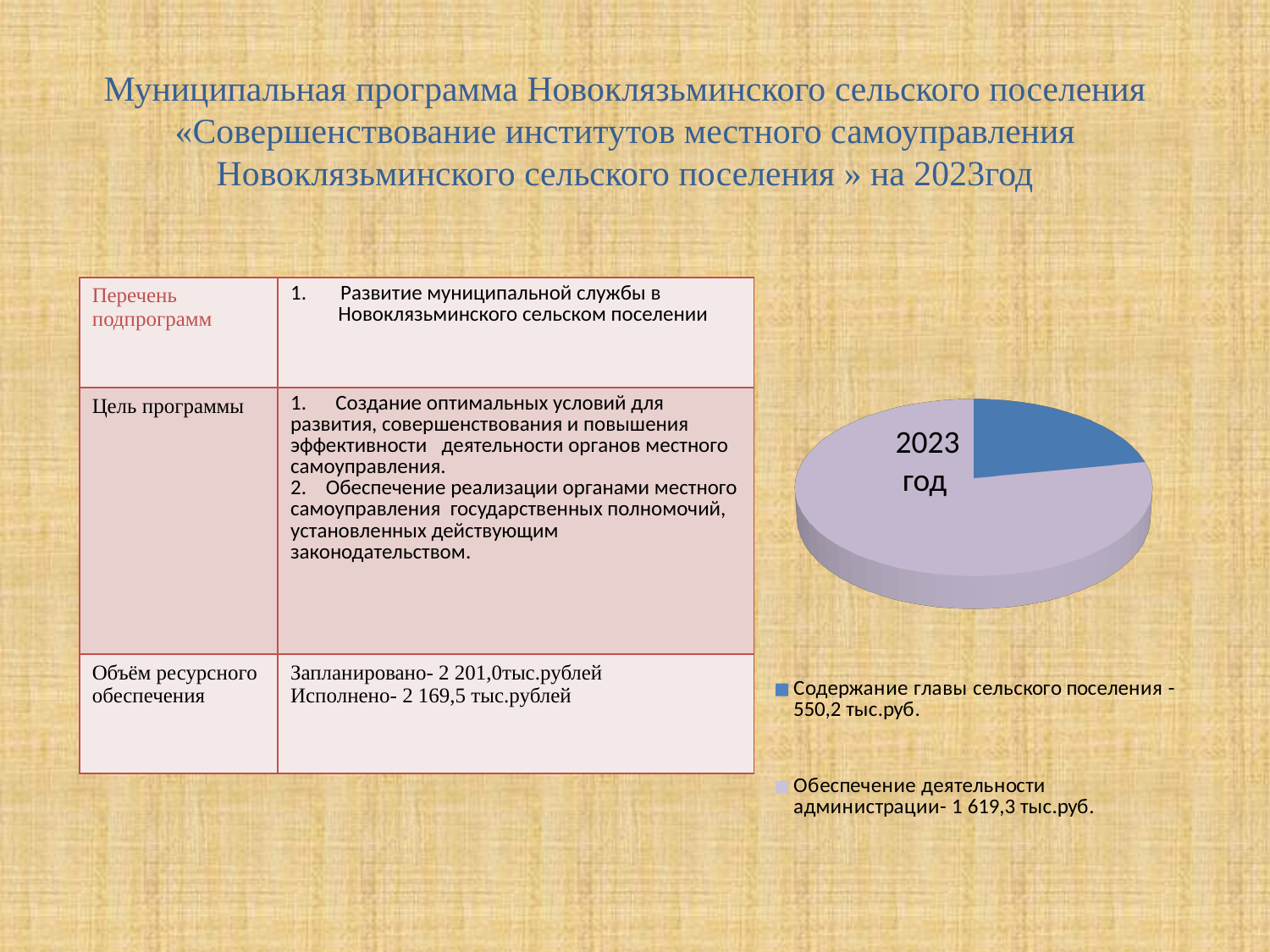
What is the value for "Обеспечение деятельности администрации" in the pie chart? 1 619,3 тыс.руб. What is the total of the two values shown in the pie chart legend? 2 169,5 тыс.руб. What colour is the slice for "Содержание главы сельского поселения" in the pie chart? Blue How many slices does the pie chart have? 2 What is the value for "Содержание главы сельского поселения" in the pie chart? 550,2 тыс.руб. How many entries does the legend of the pie chart list? 2 What kind of chart is shown on the slide? Pie chart What is the difference between "Обеспечение деятельности администрации" and "Содержание главы сельского поселения" in the pie chart? 1 069,1 тыс.руб. Which is larger: "Содержание главы сельского поселения" or "Обеспечение деятельности администрации"? Обеспечение деятельности администрации Which category has the largest slice in the pie chart? Обеспечение деятельности администрации What title is shown on the pie chart? 2023 год Which category has the smallest slice in the pie chart? Содержание главы сельского поселения